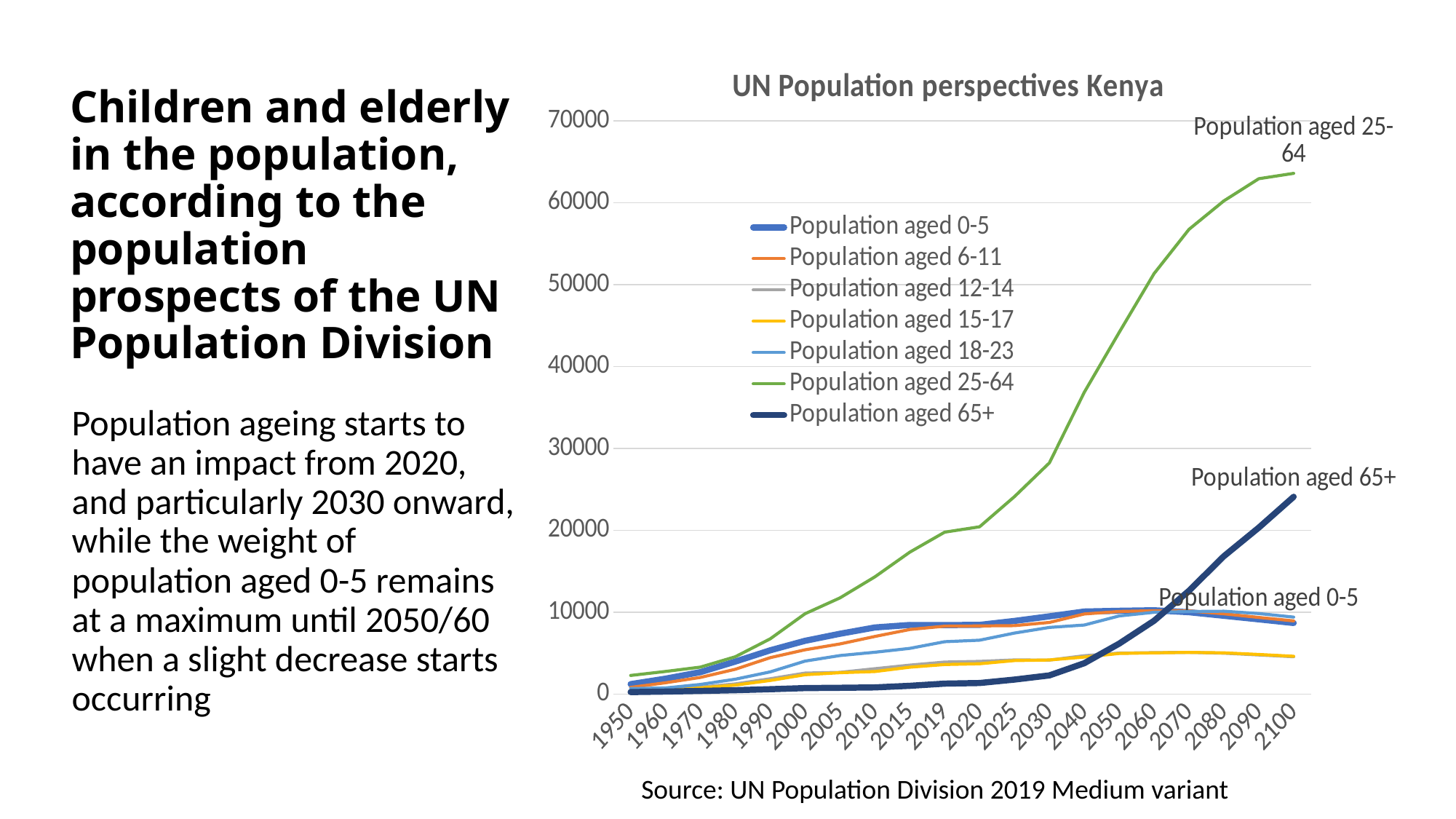
Does the Population aged 25-64 series rise or fall from 1950 to 2100? rise What is the title of the chart? UN Population perspectives Kenya Is the value for Population aged 25-64 in 2040 greater or less than 30000? greater Is the value for Population aged 65+ in 2100 greater or less than 20000? greater How many years are labelled along the x axis of the chart? 20 What kind of chart is shown on the slide? line chart In 2100, which is larger: Population aged 0-5 or Population aged 65+? Population aged 65+ Is the value for Population aged 65+ in 2030 greater or less than 10000? less How many series does the chart legend list? 7 Which series has the highest value in 2100? Population aged 25-64 Which series has the lowest value in 1950? Population aged 65+